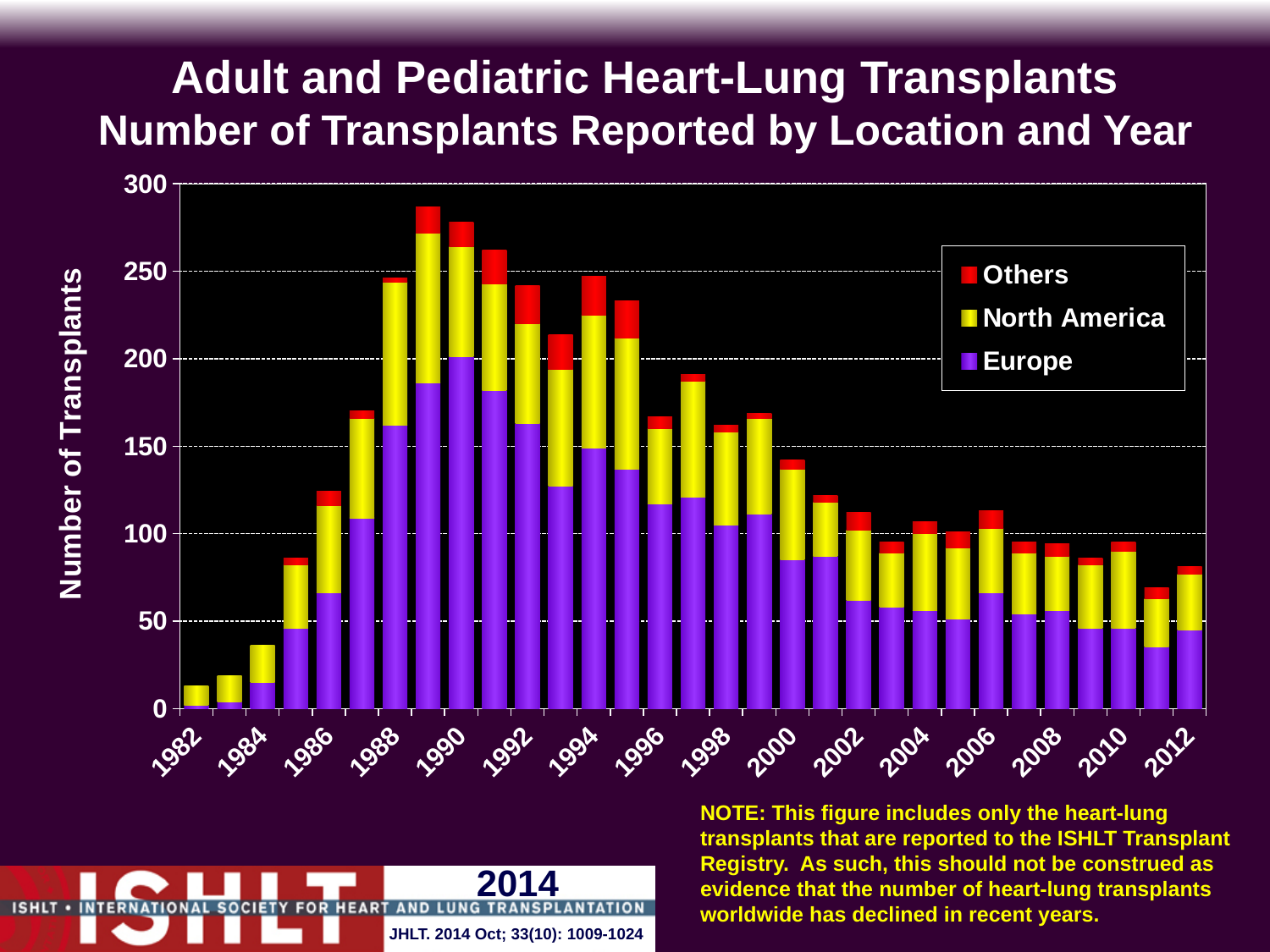
Do the total numbers of transplants generally rise or fall from 1989 to 2012? fall Is the Europe portion of the 1990 bar greater or less than 150? greater Which series is shown in purple in the legend? Europe Is the total number of transplants in 2012 greater or less than 100? less Which series is shown in red in the legend? Others Which year has a higher total number of transplants, 1987 or 2000? 1987 Which year has the shortest bar (lowest total number of transplants)? 1982 Which year has the tallest bar (highest total number of transplants)? 1989 Is the total number of transplants in 1989 greater or less than 250? greater What kind of chart is shown on the slide? Stacked bar chart How many series does the legend list? 3